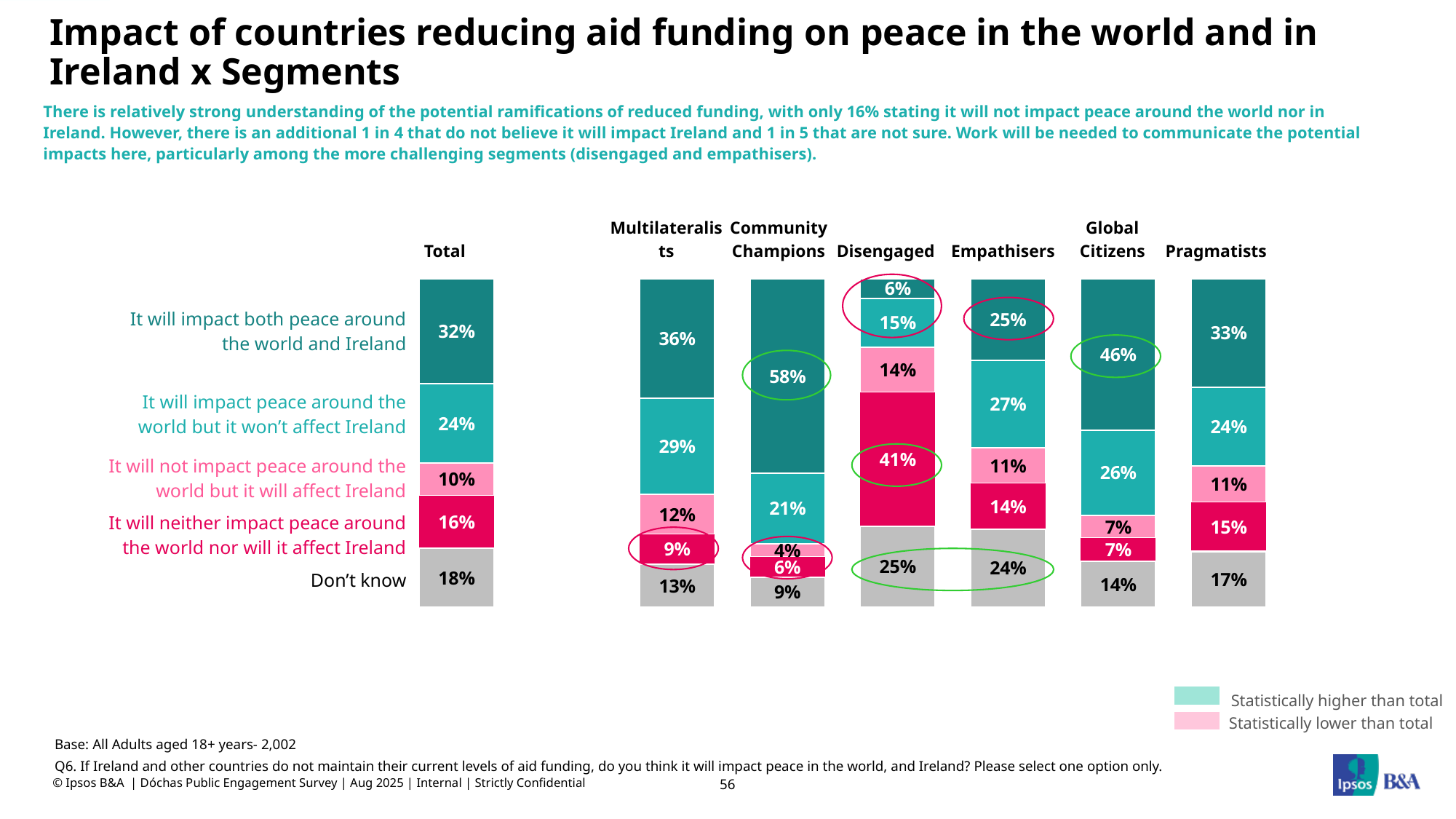
Which is larger: the Don't know share for Multilateralists or for Pragmatists? Pragmatists What type of chart is shown on the slide? Stacked bar chart What percentage of Empathisers answered Don't know? 24% What is the difference between Global Citizens and the Total for 'It will impact both peace around the world and Ireland'? 14 percentage points What percentage of the Total say it will impact both peace around the world and Ireland? 32% What percentage of Community Champions say it will impact both peace around the world and Ireland? 58% Which segment has the highest share saying it will impact both peace around the world and Ireland? Community Champions How many segment bars are shown in addition to the Total bar? 6 What percentage of the Disengaged segment say it will neither impact peace around the world nor affect Ireland? 41% What does the green highlight in the legend indicate? Statistically higher than total Which segment has the lowest share saying it will impact both peace around the world and Ireland? Disengaged How many response categories are stacked in each bar? 5